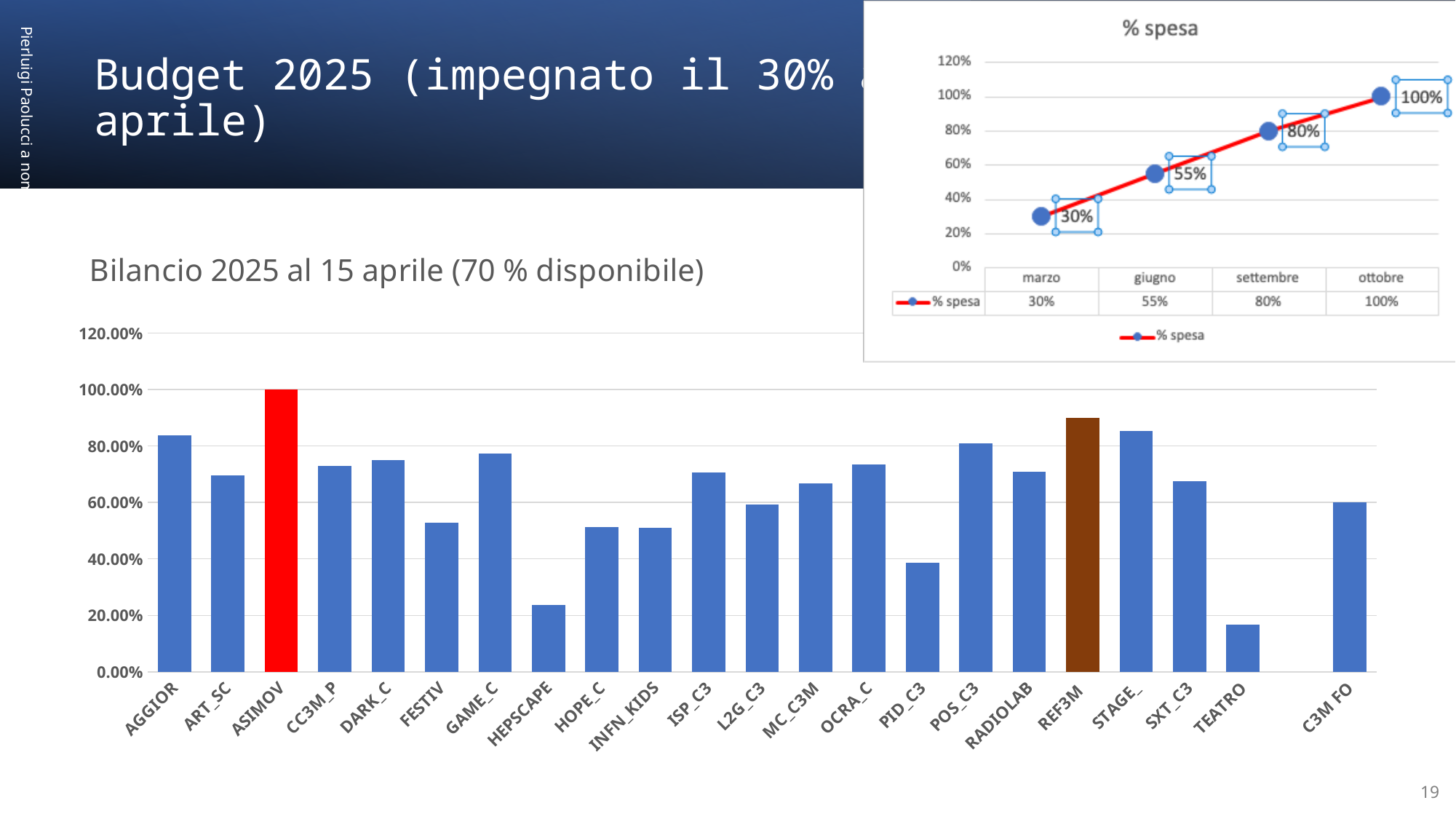
In the 'Bilancio 2025 al 15 aprile' chart, what colour is the ASIMOV bar? red In the '% spesa' chart, what is the difference between the values for ottobre and marzo? 70% In the 'Bilancio 2025 al 15 aprile' chart, which category has the lowest value? TEATRO In the 'Bilancio 2025 al 15 aprile' chart, is the value for REF3M greater or less than 80.00%? greater In the '% spesa' chart, do the values rise or fall from marzo to ottobre? rise In the '% spesa' chart, what is the value for settembre? 80% In the 'Bilancio 2025 al 15 aprile' chart, is the value for HEPSCAPE greater or less than 40.00%? less In the 'Bilancio 2025 al 15 aprile' chart, which category has the highest value? ASIMOV In the '% spesa' chart, what is the value for giugno? 55% In the 'Bilancio 2025 al 15 aprile' chart, which is larger, the value for AGGIOR or the value for PID_C3? AGGIOR In the '% spesa' chart, how many data points are plotted? 4 What kind of chart is the '% spesa' chart? line chart